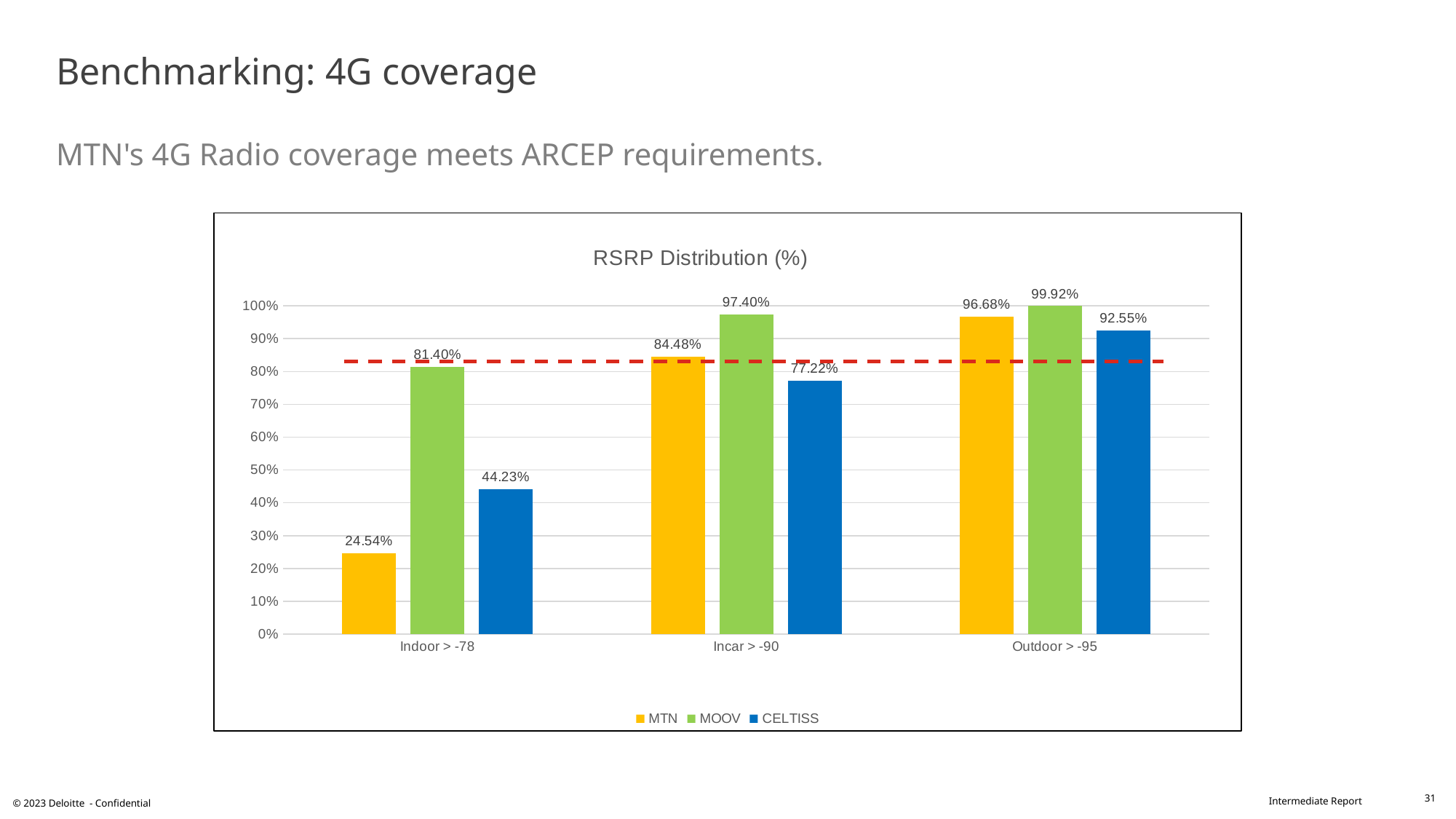
Which series has the lowest value in the Outdoor > -95 category? CELTISS How many series does the legend list? 3 What is the value for MOOV in the Outdoor > -95 category? 99.92% What is the value for MTN in the Indoor > -78 category? 24.54% Is the value for CELTISS in the Indoor > -78 category greater or less than 50%? less What is the value for CELTISS in the Incar > -90 category? 77.22% What is the difference between MOOV and MTN in the Incar > -90 category? 12.92% Which is larger in the Outdoor > -95 category: MTN or CELTISS? MTN What kind of chart is shown on the slide? Bar chart Which series has the highest value in the Indoor > -78 category? MOOV How many categories are shown on the x axis? 3 What is the title of the chart? RSRP Distribution (%)